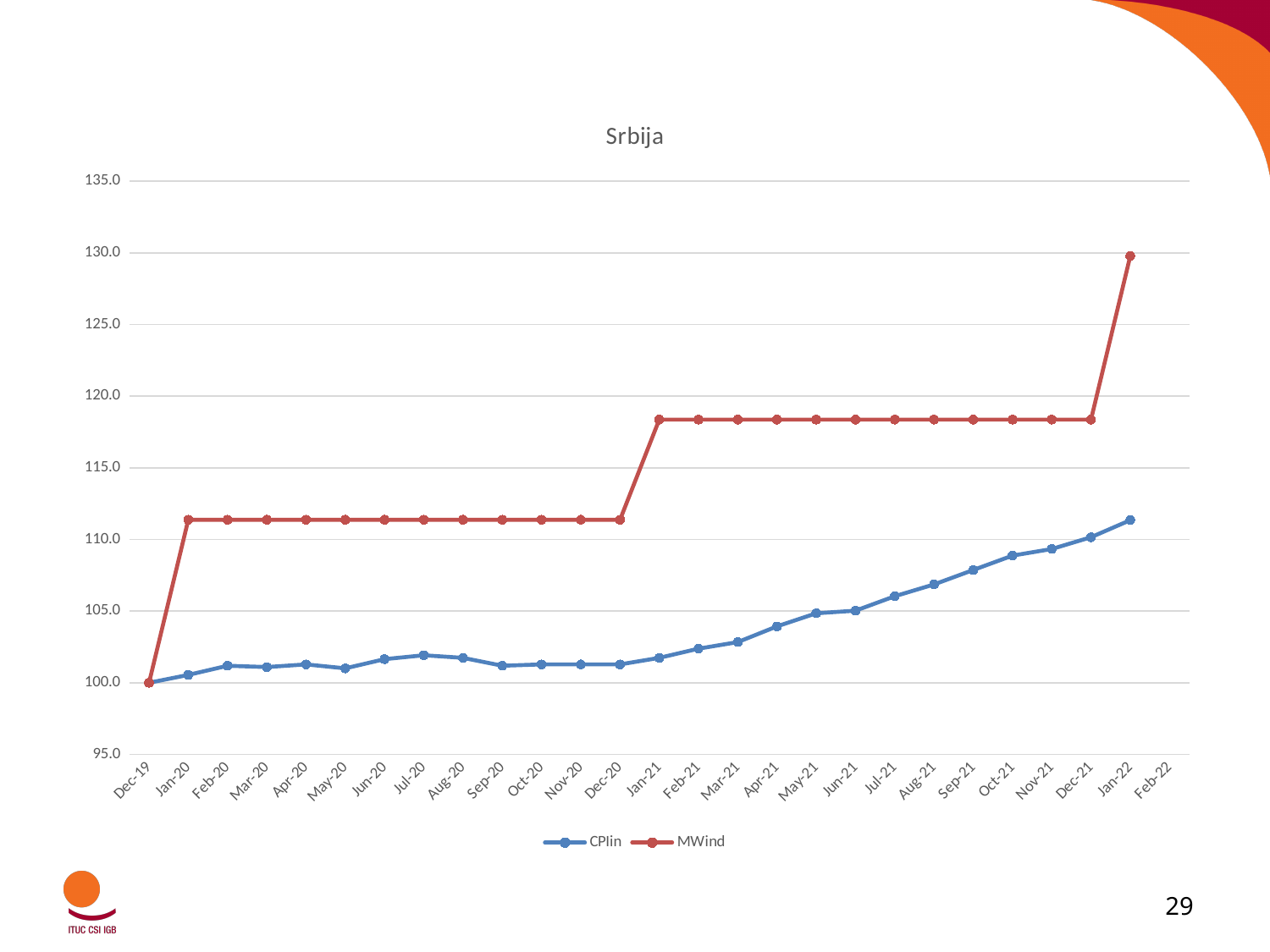
How many series does the legend list? 2 At which month does MWind reach its highest value? Jan-22 What is the value of MWind at Dec-19? 100.0 Is the value for CPIin at Jun-20 greater or less than 105.0? less What are the two series named in the legend? CPIin and MWind Is the value for MWind at Jan-22 greater or less than 125.0? greater At Jun-21, which series has the higher value, CPIin or MWind? MWind What is the value of CPIin at Dec-19? 100.0 Does the CPIin series generally rise or fall from Dec-19 to Jan-22? rise What kind of chart is shown on the slide? line chart What is the title of the chart? Srbija Is the value for MWind at Mar-21 greater or less than 120.0? less